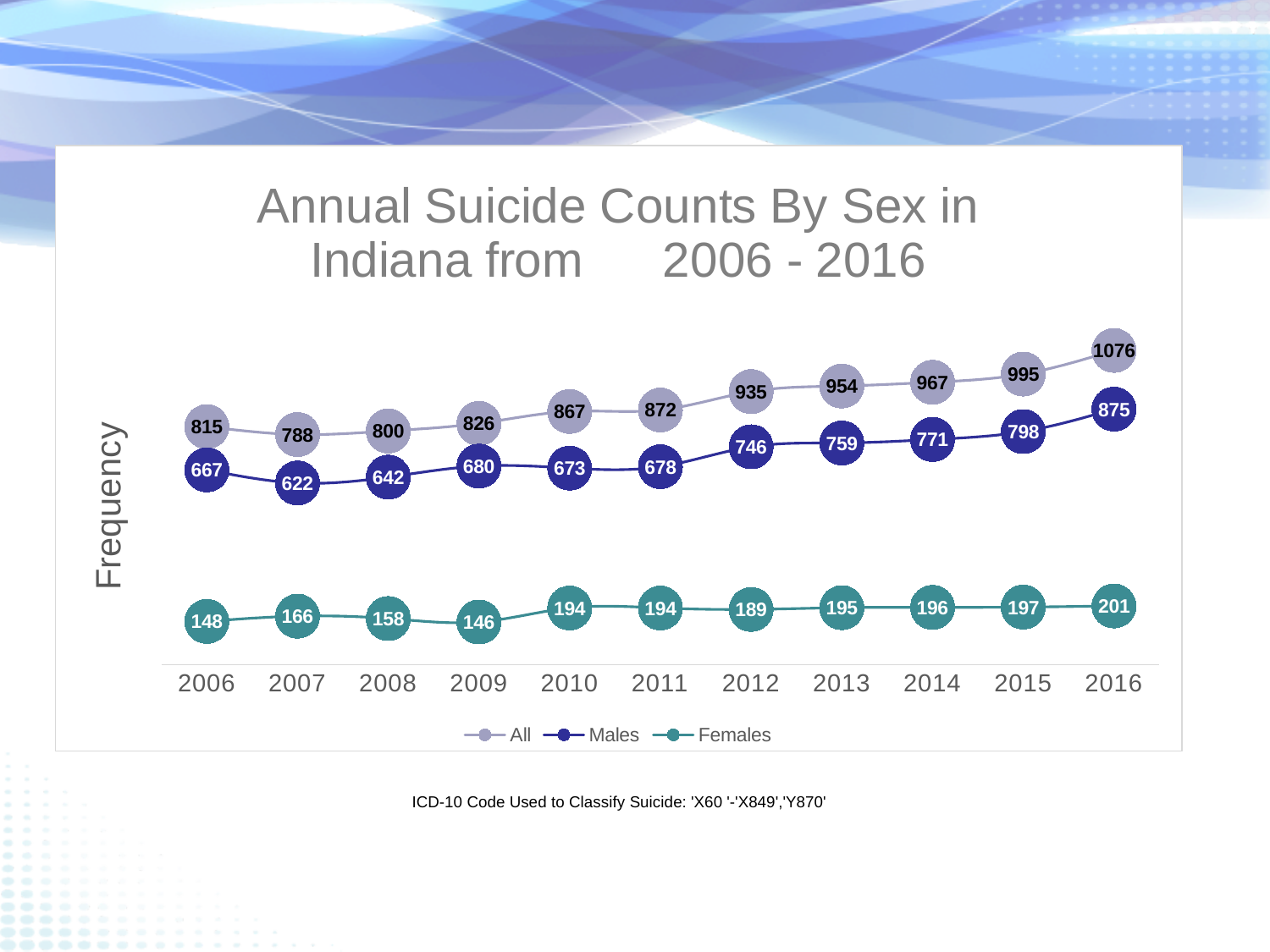
What is the title of the chart? Annual Suicide Counts By Sex in Indiana from 2006 - 2016 In which year is the Females series lowest? 2009 Which is larger, the Males value in 2012 or the Males value in 2011? 2012 What is the value for Males in 2007? 622 How many years are shown on the x axis? 11 What is the value for Females in 2009? 146 How many series does the legend list? 3 What is the value for All in 2016? 1076 What kind of chart is shown? line chart Does the All series generally rise or fall from 2006 to 2016? rise In which year is the Males series highest? 2016 What is the difference between the All value in 2016 and the All value in 2006? 261